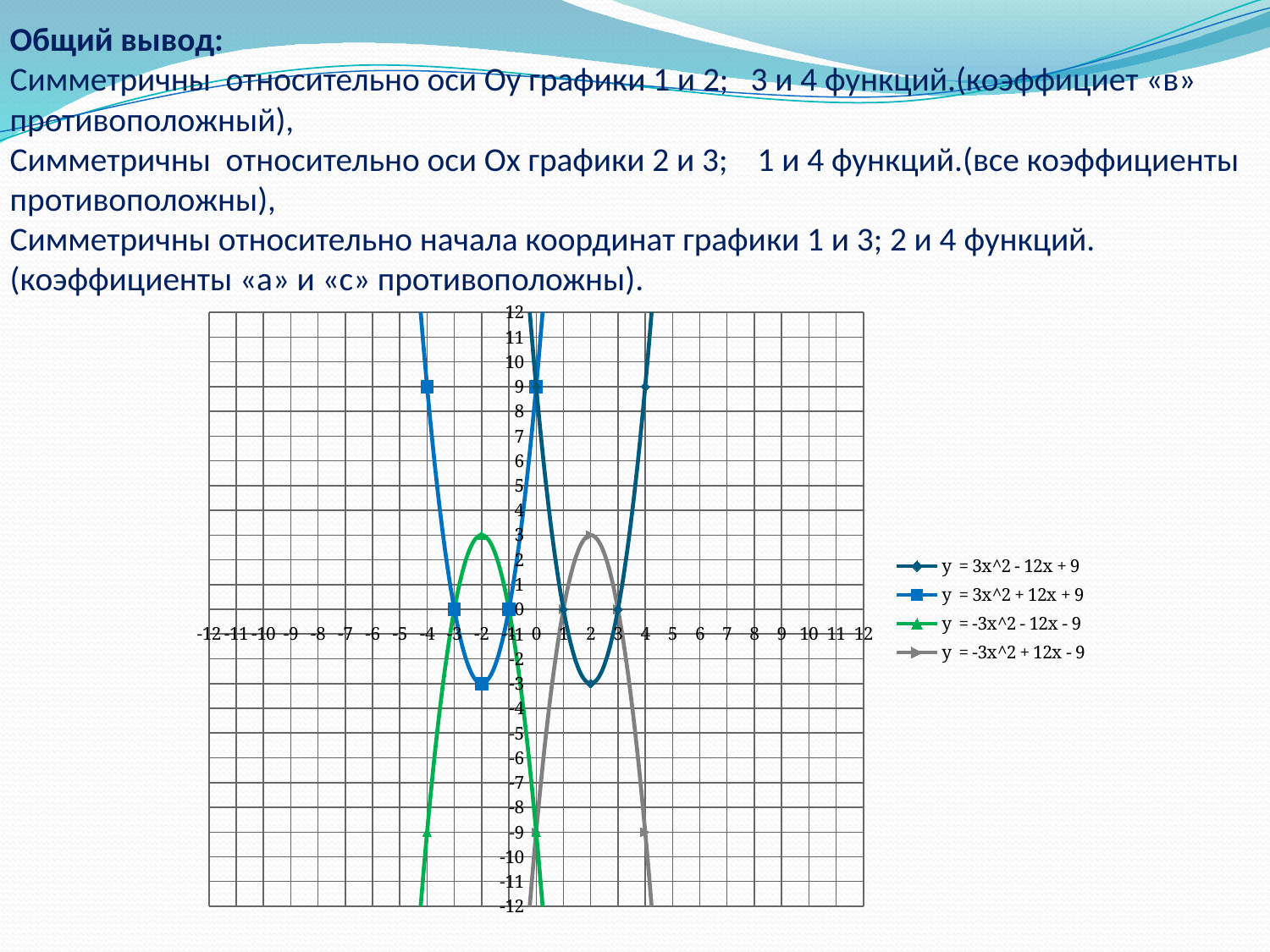
What is the difference between y = 3x^2 - 12x + 9 and y = -3x^2 - 12x - 9 at x = 0? 18 What marker shape is used for the series y = 3x^2 + 12x + 9? square What is the value of y = 3x^2 - 12x + 9 at x = 2? -3 What is the value of y = 3x^2 + 12x + 9 at x = -2? -3 At x = 2, which is larger: y = 3x^2 - 12x + 9 or y = -3x^2 + 12x - 9? y = -3x^2 + 12x - 9 What is the value of y = -3x^2 + 12x - 9 at x = 2? 3 What is the lowest value shown on the x axis? -12 What is the value of y = -3x^2 - 12x - 9 at x = -2? 3 What kind of chart is shown on the slide? line chart How many series does the legend list? 4 What is the value of y = 3x^2 + 12x + 9 at x = 0? 9 Does y = 3x^2 - 12x + 9 rise or fall as x goes from 0 to 2? fall